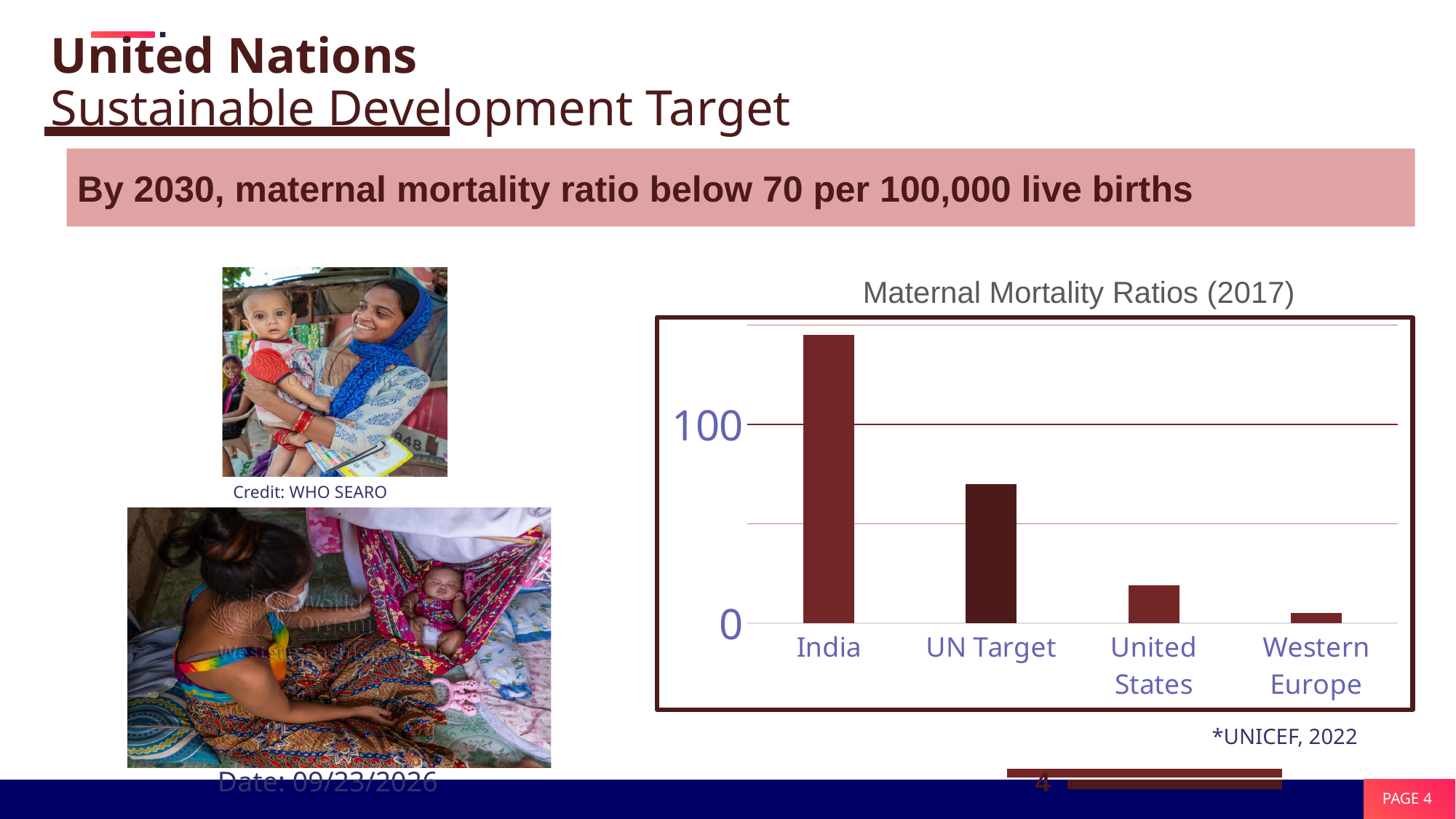
Which category has the highest maternal mortality ratio in the chart? India How many categories are plotted in the chart? 4 Which category has the lowest maternal mortality ratio in the chart? Western Europe Is the value for UN Target greater or less than 100? less What are the two tick values labelled on the vertical axis of the chart? 0 and 100 Which is larger, the value for United States or the value for Western Europe? United States What type of chart is shown on the slide? bar chart What is the title of the chart? Maternal Mortality Ratios (2017) Do the bar values rise or fall from left to right across the categories? fall Is the value for United States greater or less than 100? less Which is larger, the value for India or the value for UN Target? India Is the value for India greater or less than 100? greater